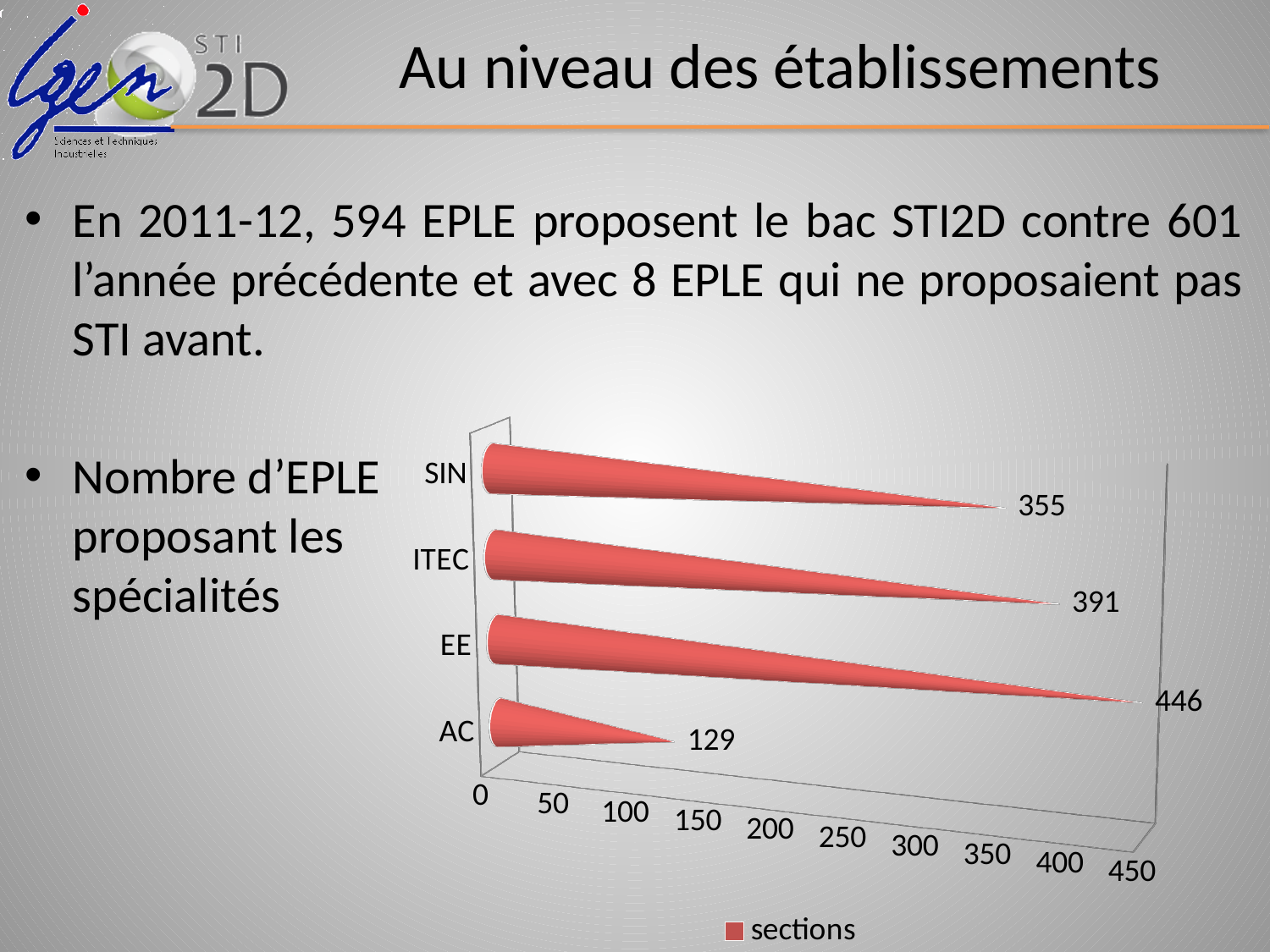
What is the difference between the values for ITEC and SIN? 36 What is the value for EE? 446 What is the name of the series shown in the legend? sections Which category has the lowest value? AC What is the value for SIN? 355 What is the value for AC? 129 How many series does the legend list? 1 What is the difference between the values for EE and AC? 317 Which is larger, the value for ITEC or the value for SIN? ITEC Which category has the highest value? EE What is the value for ITEC? 391 How many categories are shown in the chart? 4